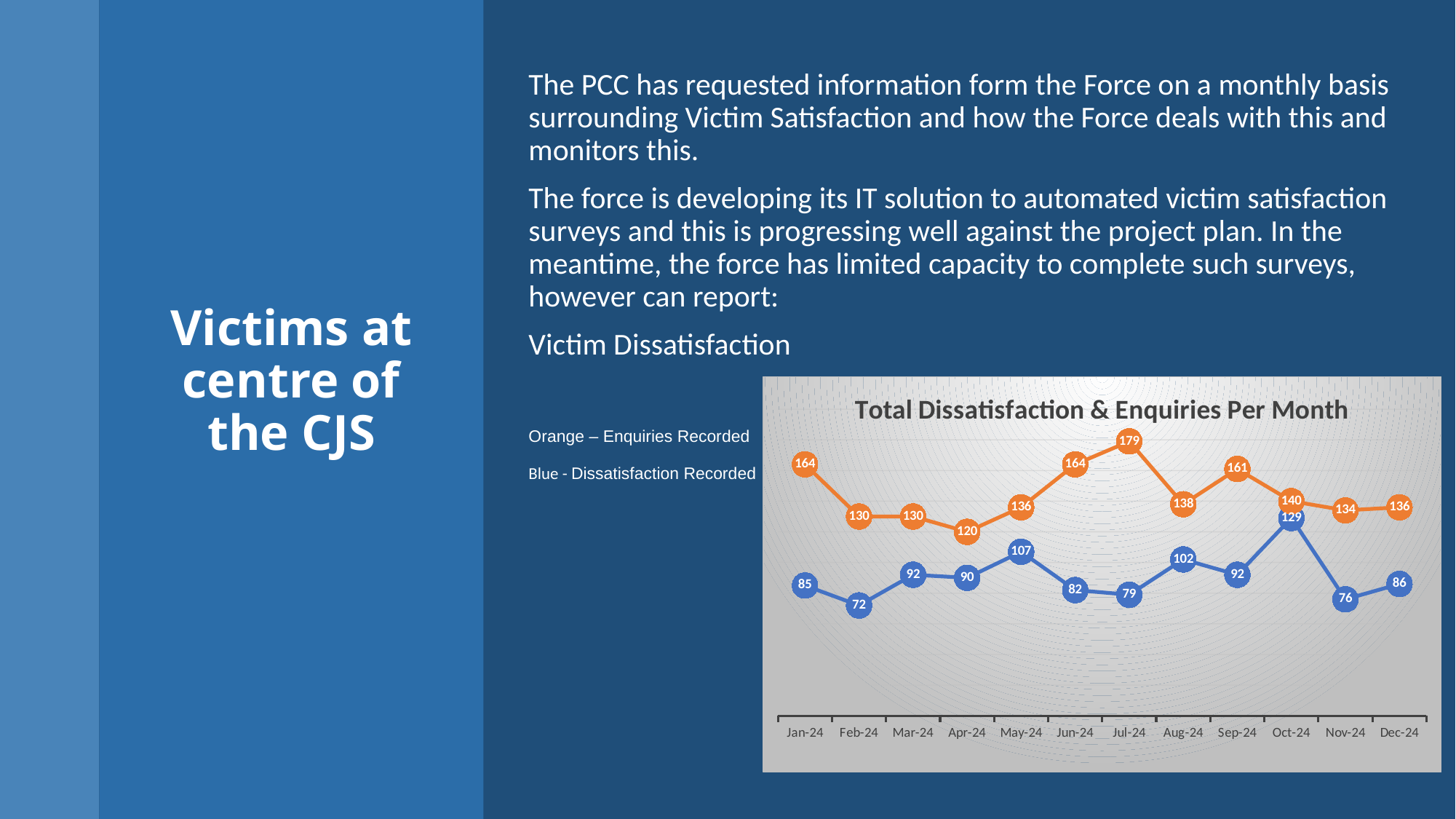
What is the difference between Enquiries Recorded and Dissatisfaction Recorded in Jan-24? 79 In which month is Enquiries Recorded (orange line) at its lowest? Apr-24 How many data series are plotted in the chart? 2 In which month is Dissatisfaction Recorded (blue line) at its lowest? Feb-24 Which is larger: Enquiries Recorded in Jun-24 or Enquiries Recorded in Sep-24? Jun-24 How many months are plotted along the x axis of the chart? 12 In which month is Dissatisfaction Recorded (blue line) at its highest? Oct-24 What is the value of Enquiries Recorded (orange line) for Jul-24? 179 What type of chart is shown on the slide? Line chart What is the title of the chart? Total Dissatisfaction & Enquiries Per Month Does Dissatisfaction Recorded (blue line) rise or fall from Oct-24 to Nov-24? Fall What is the value of Dissatisfaction Recorded (blue line) for Oct-24? 129